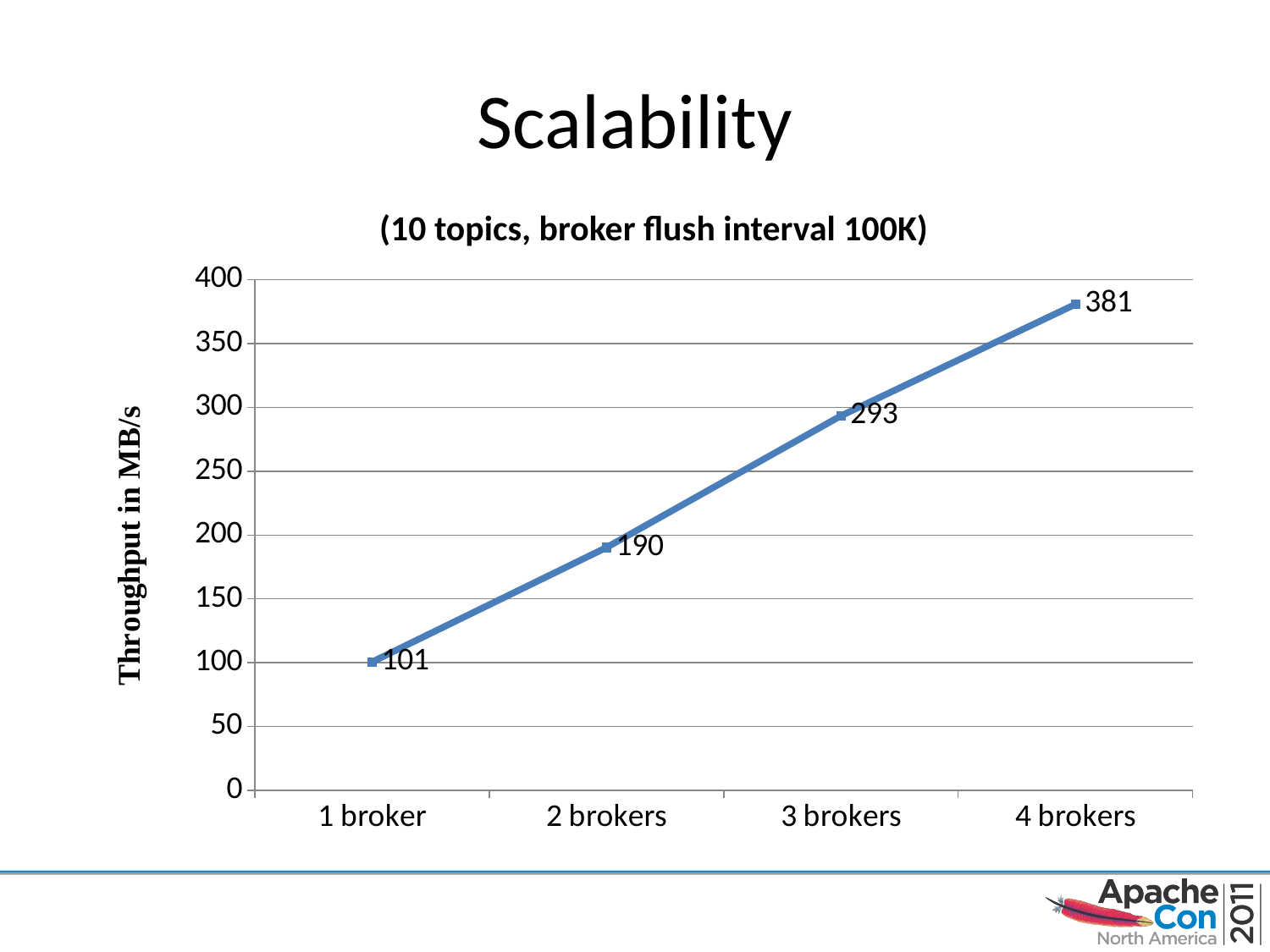
Which broker count has the lowest throughput? 1 broker What is the difference in throughput between 3 brokers and 2 brokers? 103 What is the throughput in MB/s for 3 brokers? 293 How many data points are plotted on the chart? 4 What is the difference in throughput between 4 brokers and 1 broker? 280 Which has higher throughput, 2 brokers or 3 brokers? 3 brokers What is the throughput in MB/s for 2 brokers? 190 Does throughput rise or fall as the number of brokers increases? Rises What is the throughput in MB/s for 1 broker? 101 Which broker count has the highest throughput? 4 brokers What kind of chart is shown on the slide? Line chart What is the throughput in MB/s for 4 brokers? 381